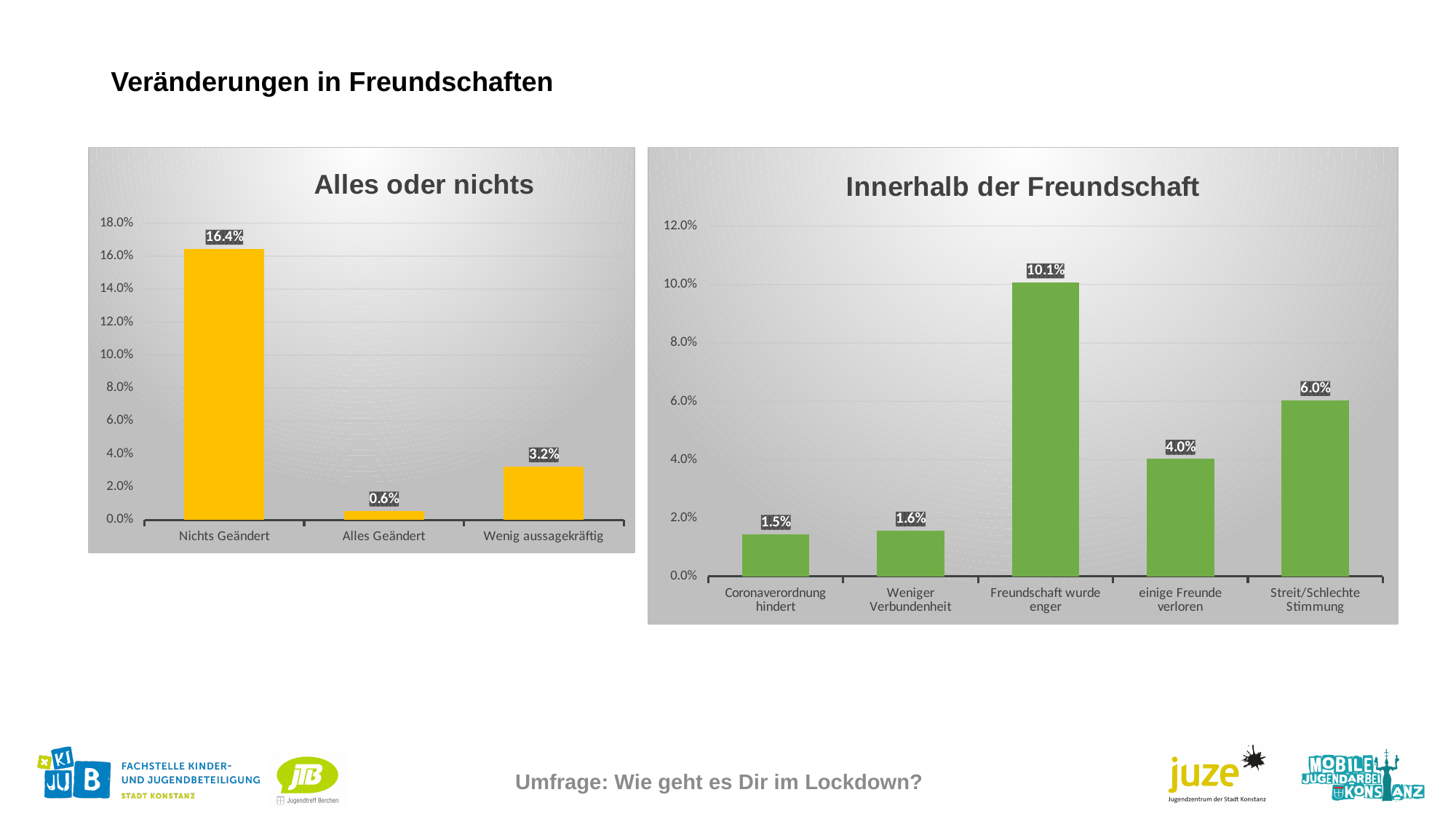
In the 'Innerhalb der Freundschaft' chart, how many categories are shown? 5 What colour are the bars in the 'Alles oder nichts' chart? Yellow In the 'Innerhalb der Freundschaft' chart, which is larger: 'einige Freunde verloren' or 'Streit/Schlechte Stimmung'? Streit/Schlechte Stimmung In the 'Alles oder nichts' chart, what is the value for 'Nichts Geändert'? 16.4% In the 'Innerhalb der Freundschaft' chart, what is the difference between 'Freundschaft wurde enger' and 'einige Freunde verloren'? 6.1% In the 'Alles oder nichts' chart, what is the difference between 'Nichts Geändert' and 'Wenig aussagekräftig'? 13.2% In the 'Innerhalb der Freundschaft' chart, what is the value for 'Streit/Schlechte Stimmung'? 6.0% In the 'Alles oder nichts' chart, which category has the lowest value? Alles Geändert In the 'Alles oder nichts' chart, how many categories are shown? 3 In the 'Innerhalb der Freundschaft' chart, what is the value for 'Freundschaft wurde enger'? 10.1% In the 'Innerhalb der Freundschaft' chart, which category has the highest value? Freundschaft wurde enger What type of chart is the 'Innerhalb der Freundschaft' chart? Bar chart